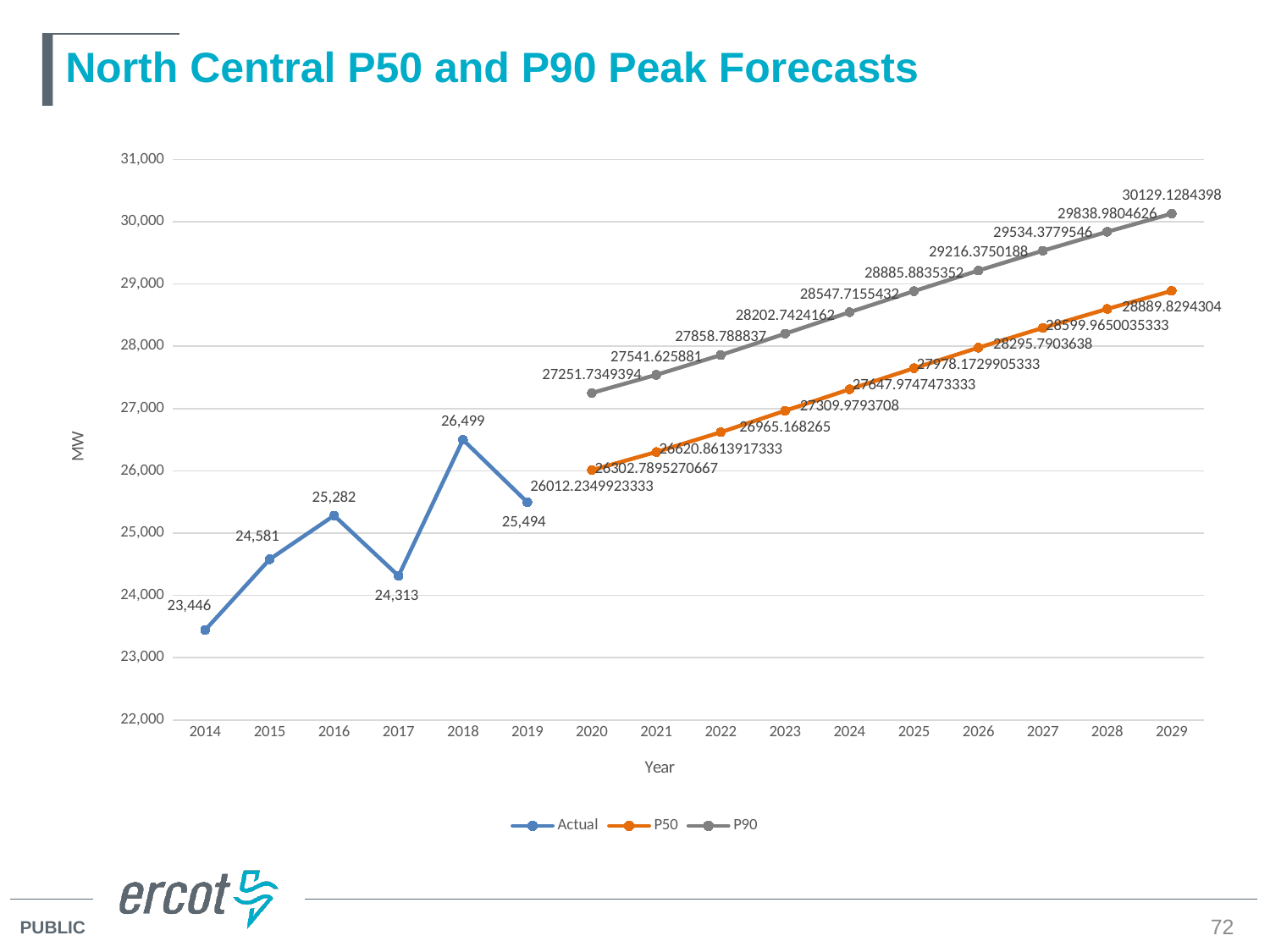
What is the Actual value for 2018? 26,499 Does the P90 series rise or fall from 2020 to 2029? rises In 2025, which is larger, the P50 value or the P90 value? P90 How many years are shown on the x axis? 16 In which year is the Actual series highest? 2018 In which year is the Actual series lowest? 2014 What is the P90 value for 2029? 30129.1284398 What is the Actual value for 2014? 23,446 What is the difference between the Actual values for 2018 and 2017? 2,186 What kind of chart is shown on the slide? line chart How many series does the legend list? 3 What is the P50 value for 2029? 28889.8294304